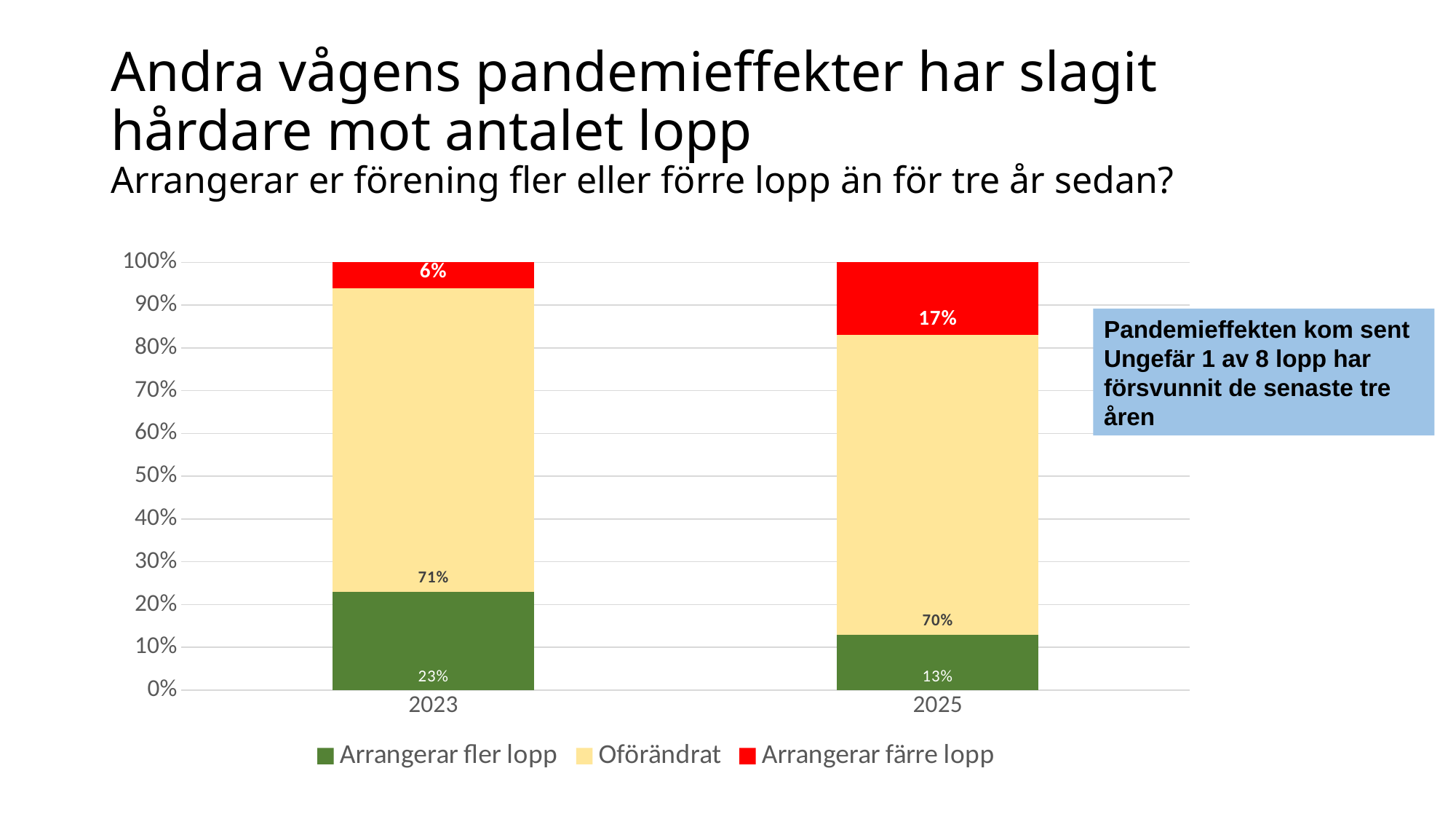
Which year has the larger share for "Arrangerar fler lopp", 2023 or 2025? 2023 What percentage of associations answered "Arrangerar färre lopp" in 2025? 17% What kind of chart is shown on the slide? Stacked bar chart What percentage of associations answered "Arrangerar fler lopp" in 2023? 23% By how many percentage points did "Arrangerar färre lopp" change from 2023 to 2025? 11 percentage points What is the value for "Arrangerar färre lopp" in 2023? 6% What is the value for "Oförändrat" in 2025? 70% Which segment is the smallest in the 2023 bar? Arrangerar färre lopp How many series does the legend list? 3 By how many percentage points did "Arrangerar fler lopp" fall from 2023 to 2025? 10 percentage points How many years are shown on the x axis? 2 Which segment is the largest in the 2025 bar? Oförändrat